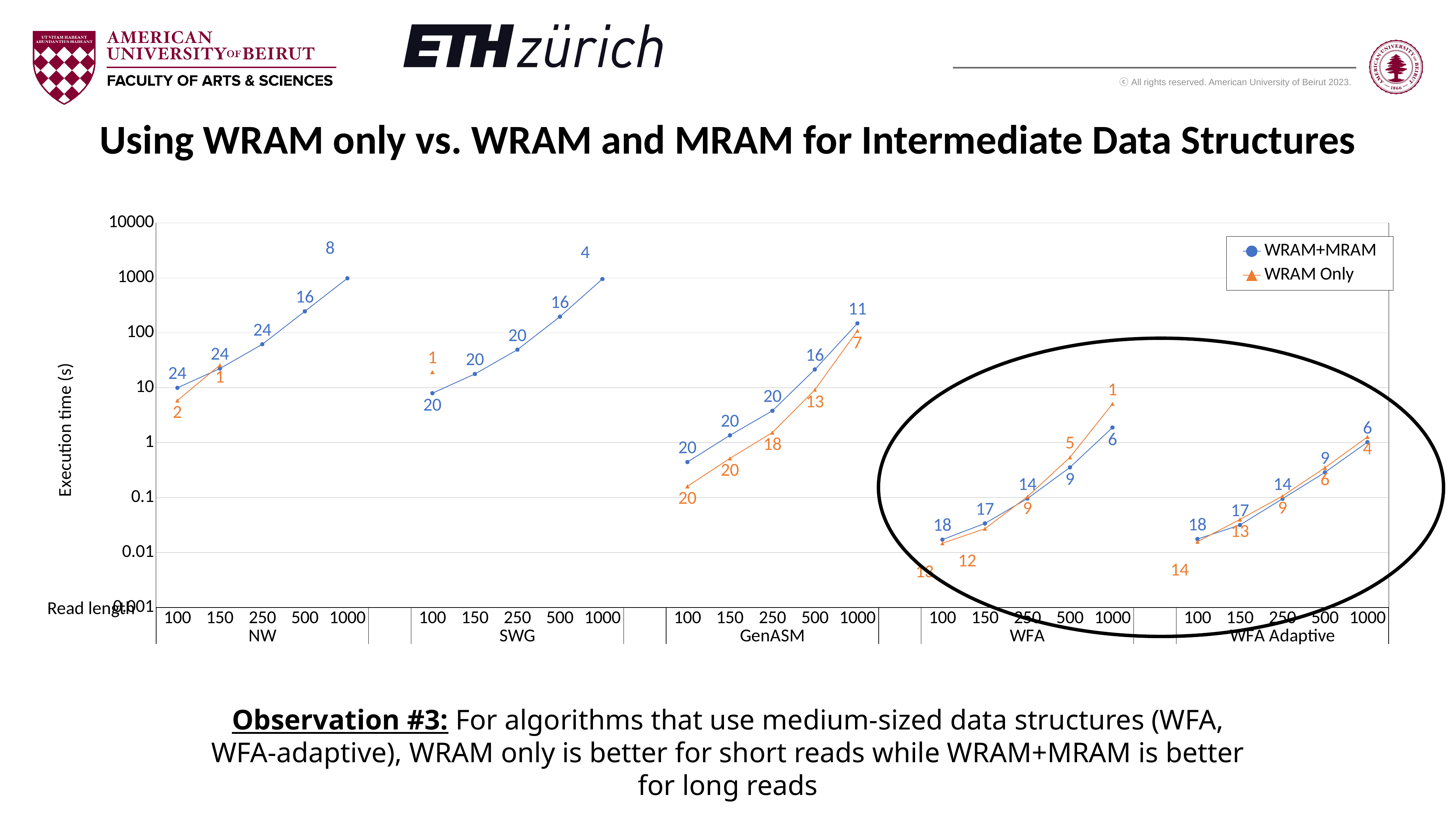
What kind of chart is shown on the slide? line chart For NW at read length 100, which series has the higher execution time, WRAM+MRAM or WRAM Only? WRAM+MRAM Is the WRAM+MRAM execution time for SWG at read length 100 greater or less than 10? less How many series does the legend list? 2 What are the two series named in the legend? WRAM+MRAM and WRAM Only For WFA at read length 1000, which series has the higher execution time, WRAM+MRAM or WRAM Only? WRAM Only Does execution time rise or fall as read length increases for the NW algorithm? rise What is the label of the y axis? Execution time (s) Is the WRAM Only execution time for WFA at read length 1000 greater or less than 1? greater How many read lengths are plotted for each algorithm? 5 Is the WRAM Only execution time for GenASM at read length 100 greater or less than 0.1? greater How many algorithm groups are shown along the x axis? 5